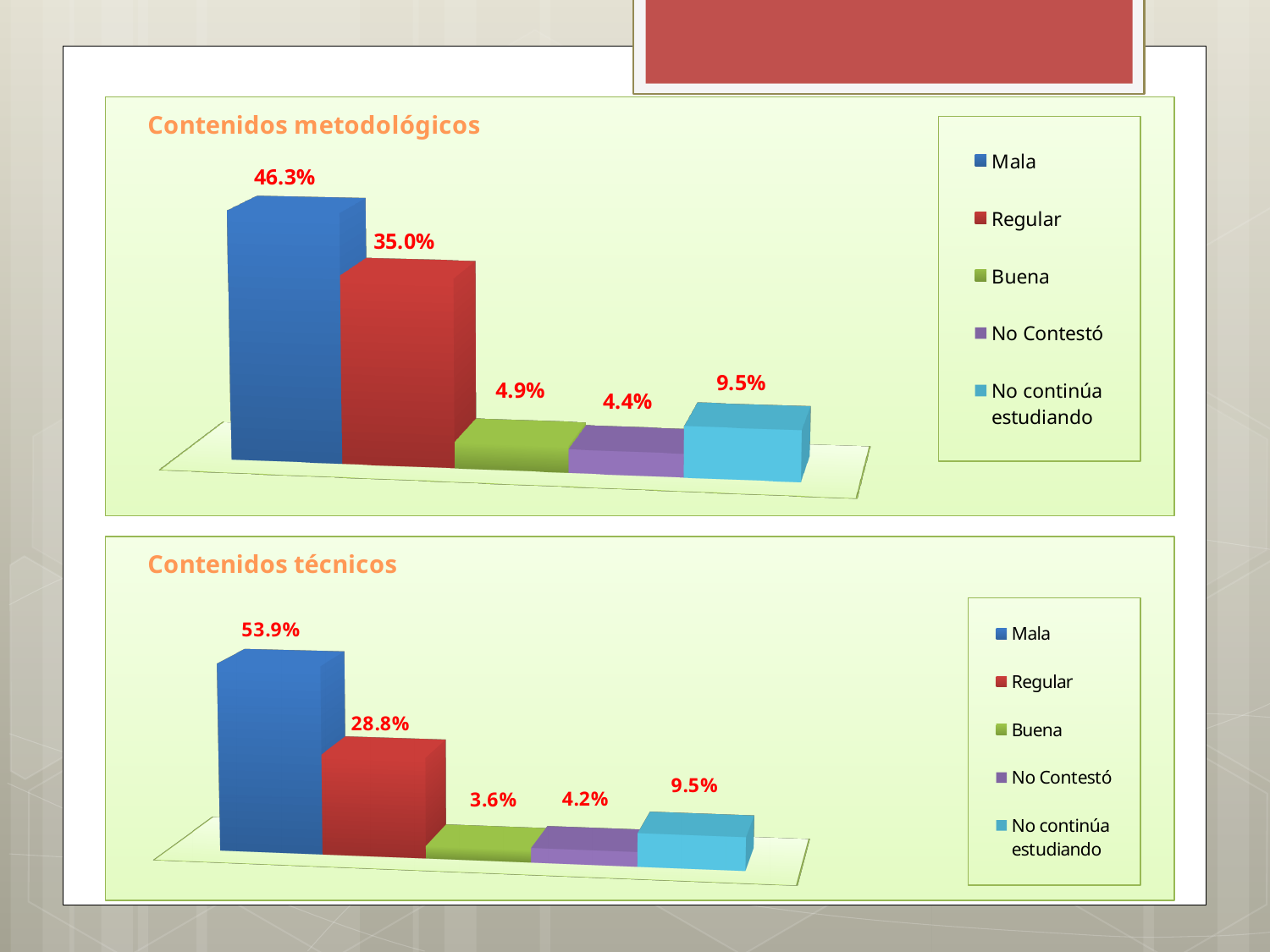
What type of chart is the 'Contenidos técnicos' chart? Bar chart How many bars are plotted in the 'Contenidos técnicos' chart? 5 In the 'Contenidos metodológicos' chart, which category has the highest value? Mala In the 'Contenidos técnicos' chart, what is the value for Buena? 3.6% In the 'Contenidos técnicos' chart, which category has the lowest value? Buena How many entries does the legend of the 'Contenidos metodológicos' chart list? 5 In the 'Contenidos metodológicos' chart, what is the value for Mala? 46.3% In the 'Contenidos técnicos' chart, what is the value for Mala? 53.9% In the 'Contenidos metodológicos' chart, which is larger, the value for Buena or the value for No continúa estudiando? No continúa estudiando In the 'Contenidos técnicos' chart, what is the difference between the values for Mala and Regular? 25.1% In the 'Contenidos metodológicos' chart, what is the value for Regular? 35.0% In the 'Contenidos metodológicos' chart, what is the difference between the values for Mala and Regular? 11.3%